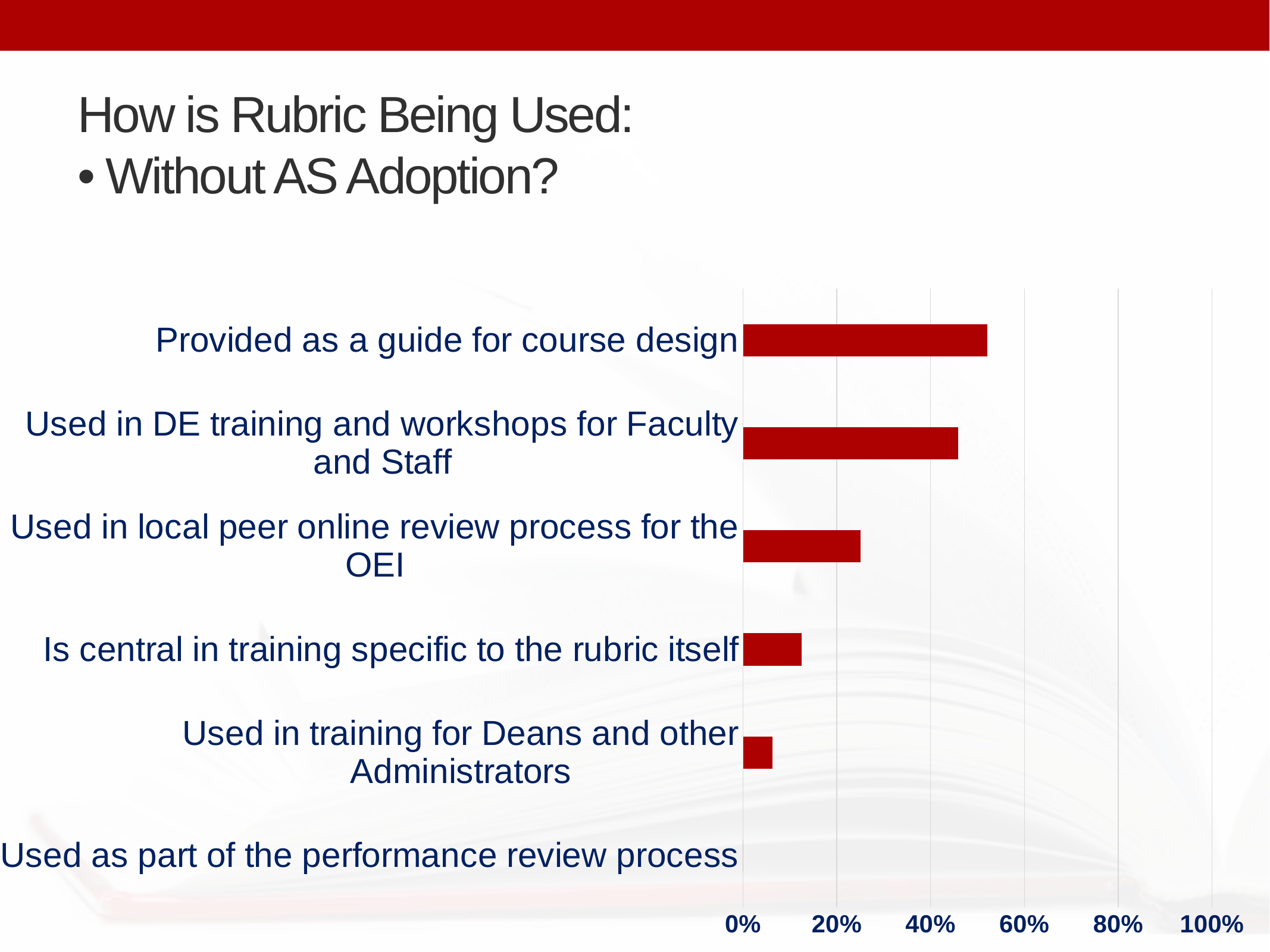
What kind of chart is shown on the slide? bar chart Is the value for "Is central in training specific to the rubric itself" greater or less than 20%? less Which category has the highest value? Provided as a guide for course design Is the value for "Provided as a guide for course design" greater or less than 40%? greater Is the value for "Used in local peer online review process for the OEI" greater or less than 40%? less Which is larger: the value for "Used in DE training and workshops for Faculty and Staff" or the value for "Used in local peer online review process for the OEI"? Used in DE training and workshops for Faculty and Staff Which category has the lowest value? Used as part of the performance review process How many categories does the chart show? 6 What colour are the bars in the chart? red